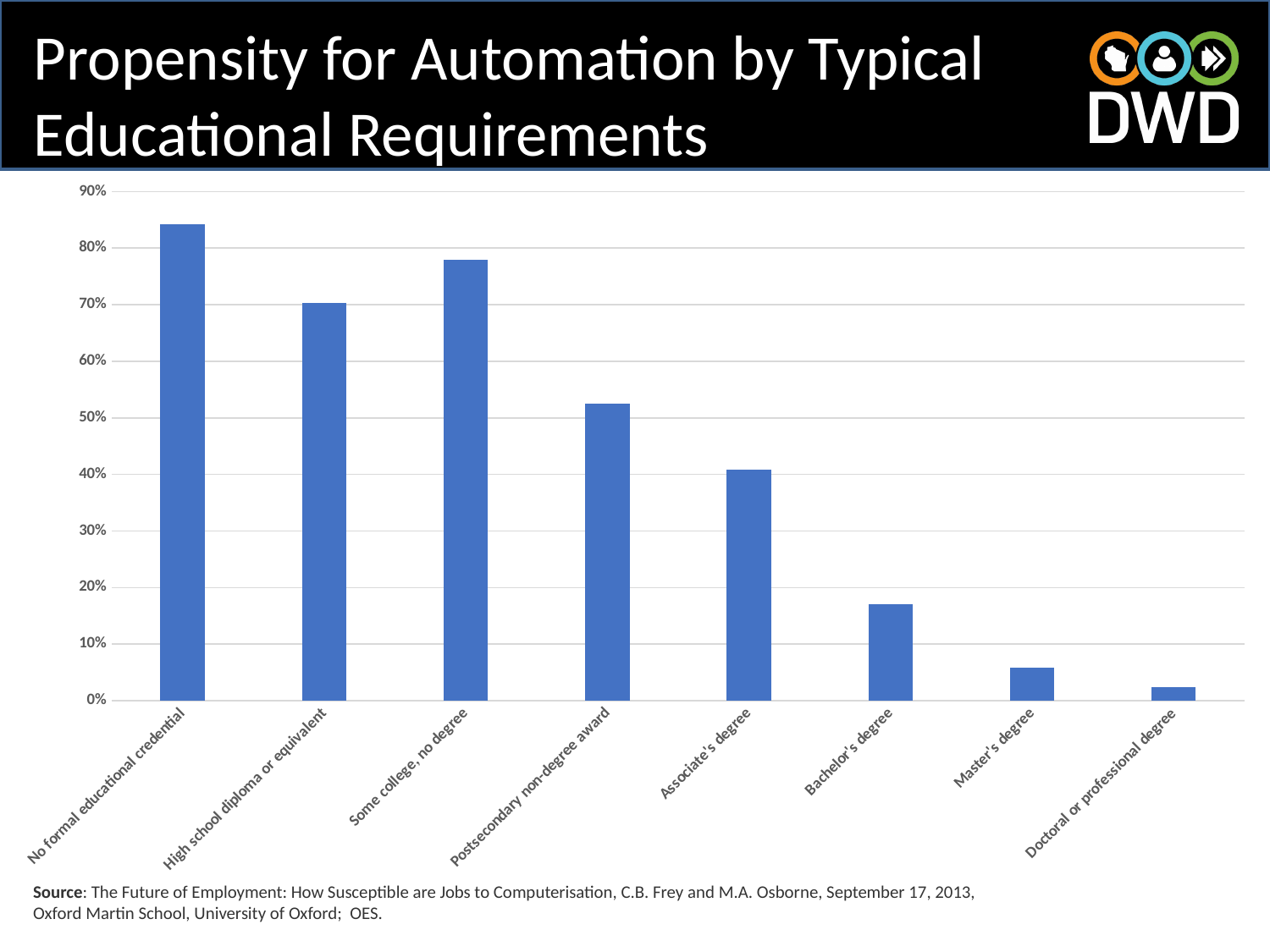
Which is larger, the value for Some college, no degree or the value for High school diploma or equivalent? Some college, no degree Which educational requirement category has the highest propensity for automation? No formal educational credential Is the value for No formal educational credential greater or less than 80%? greater Is the value for Postsecondary non-degree award greater or less than 50%? greater Which educational requirement category has the lowest propensity for automation? Doctoral or professional degree How many educational requirement categories are shown on the chart? 8 What is the highest value shown on the vertical axis of the chart? 90% What is the title of the slide containing the chart? Propensity for Automation by Typical Educational Requirements Is the value for Bachelor's degree greater or less than 20%? less What kind of chart is shown on the slide? bar chart Which is larger, the value for Associate's degree or the value for Bachelor's degree? Associate's degree